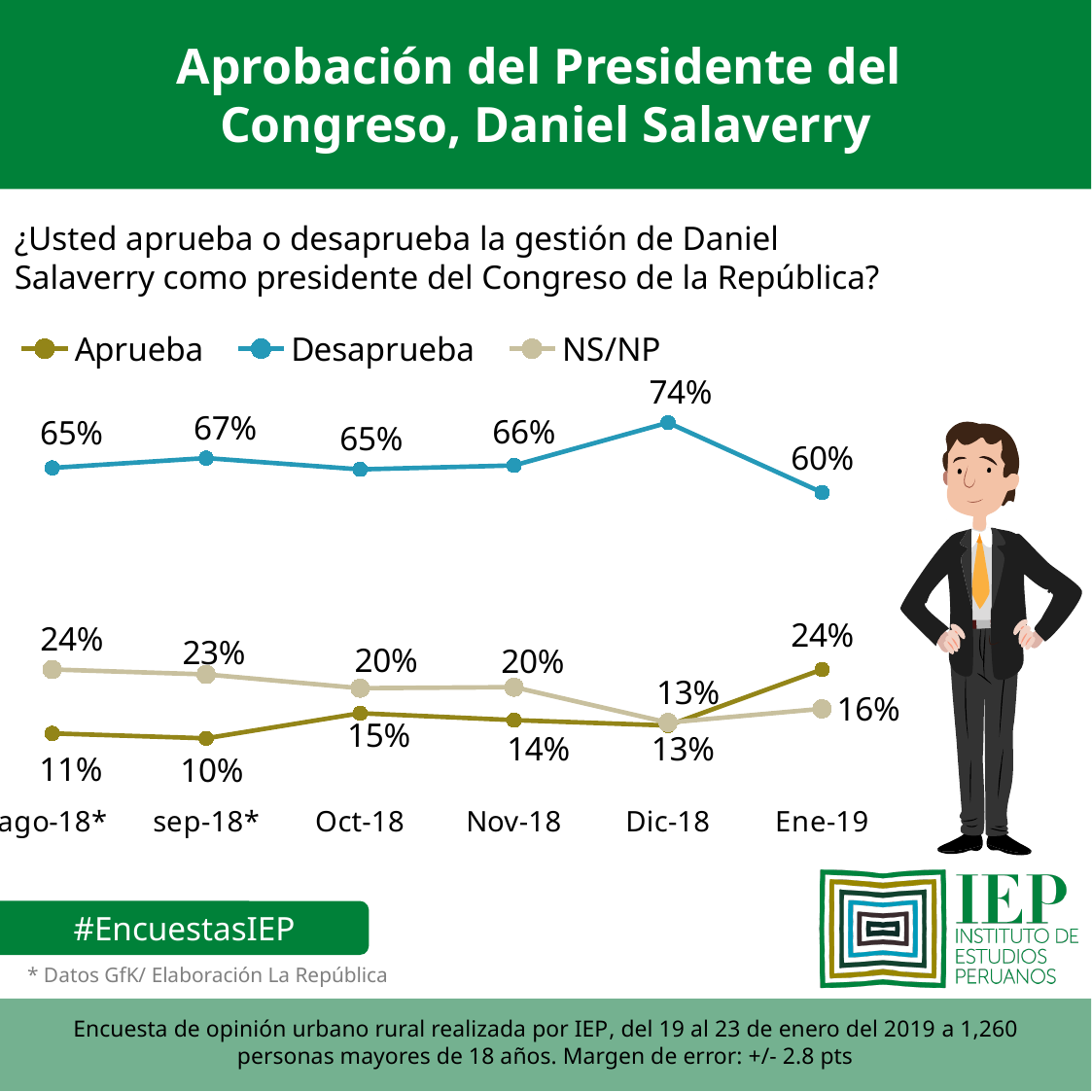
Which series is drawn in blue? Desaprueba How many series does the legend list? 3 Which is larger in Ene-19, the Aprueba value or the NS/NP value? Aprueba What type of chart is shown on the slide? line chart In which month is the Desaprueba value highest? Dic-18 What is the Desaprueba value for Dic-18? 74% In which month is the Aprueba value lowest? sep-18* What is the Aprueba value for Ene-19? 24% How many time points are plotted along the x axis? 6 What is the difference between the Desaprueba values for Dic-18 and Ene-19? 14% Does the Aprueba series rise or fall between Dic-18 and Ene-19? rise What is the NS/NP value for sep-18*? 23%